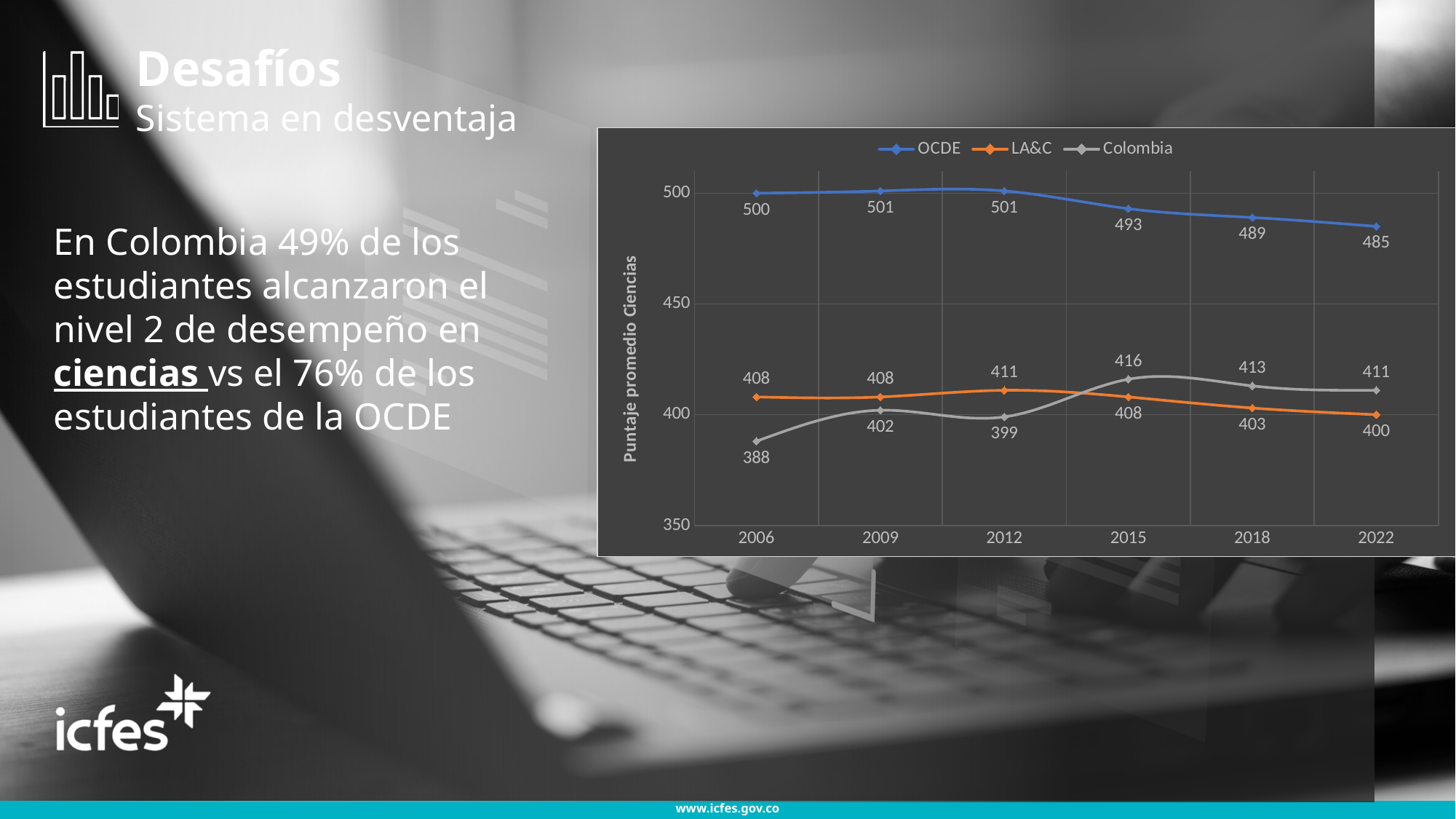
What is the LA&C value for 2022? 400 What is the label of the y axis? Puntaje promedio Ciencias How many series does the legend list? 3 What is the difference between the OCDE and Colombia values in 2022? 74 What is the OCDE value for 2006? 500 What is the Colombia value for 2015? 416 Which is larger in 2018, the LA&C value or the Colombia value? Colombia What kind of chart is shown on the slide? line chart In which year is the Colombia series highest? 2015 Does the OCDE series rise or fall from 2012 to 2022? fall How many years are shown on the x axis? 6 In which year is the Colombia series lowest? 2006